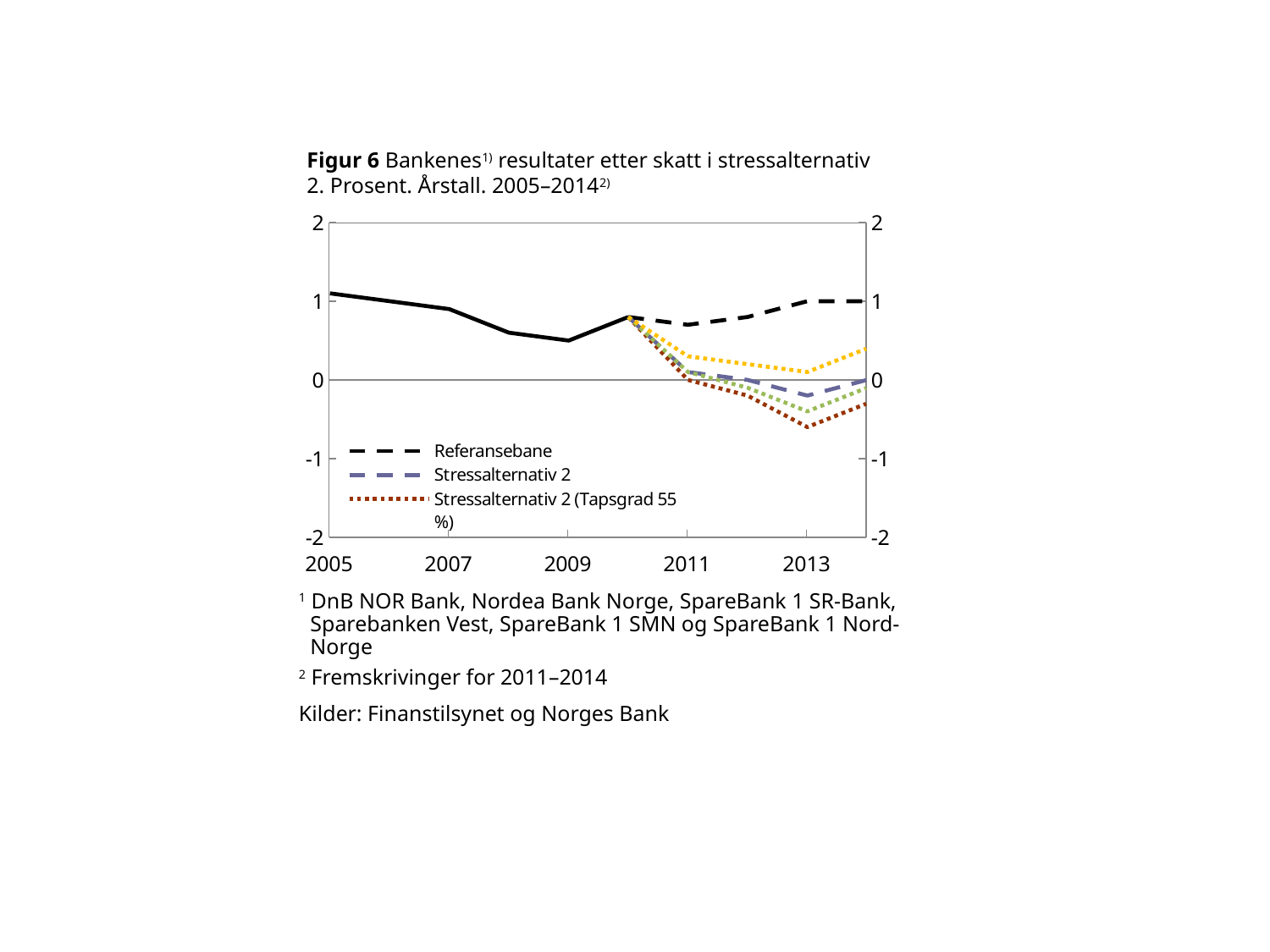
In 2013, which is larger: Referansebane or Stressalternativ 2 (Tapsgrad 55 %)? Referansebane Does the Referansebane line rise or fall from 2011 to 2014? rise Which of the legend series has the lowest value in 2013? Stressalternativ 2 (Tapsgrad 55 %) What kind of chart is shown on the slide? line chart Is the value for Stressalternativ 2 (Tapsgrad 55 %) in 2013 greater or less than 0? less How many series does the chart legend list? 3 What is the highest value shown on the left vertical axis? 2 Which series does the black dashed line in the legend represent? Referansebane Is the value for Referansebane in 2013 greater or less than 0? greater